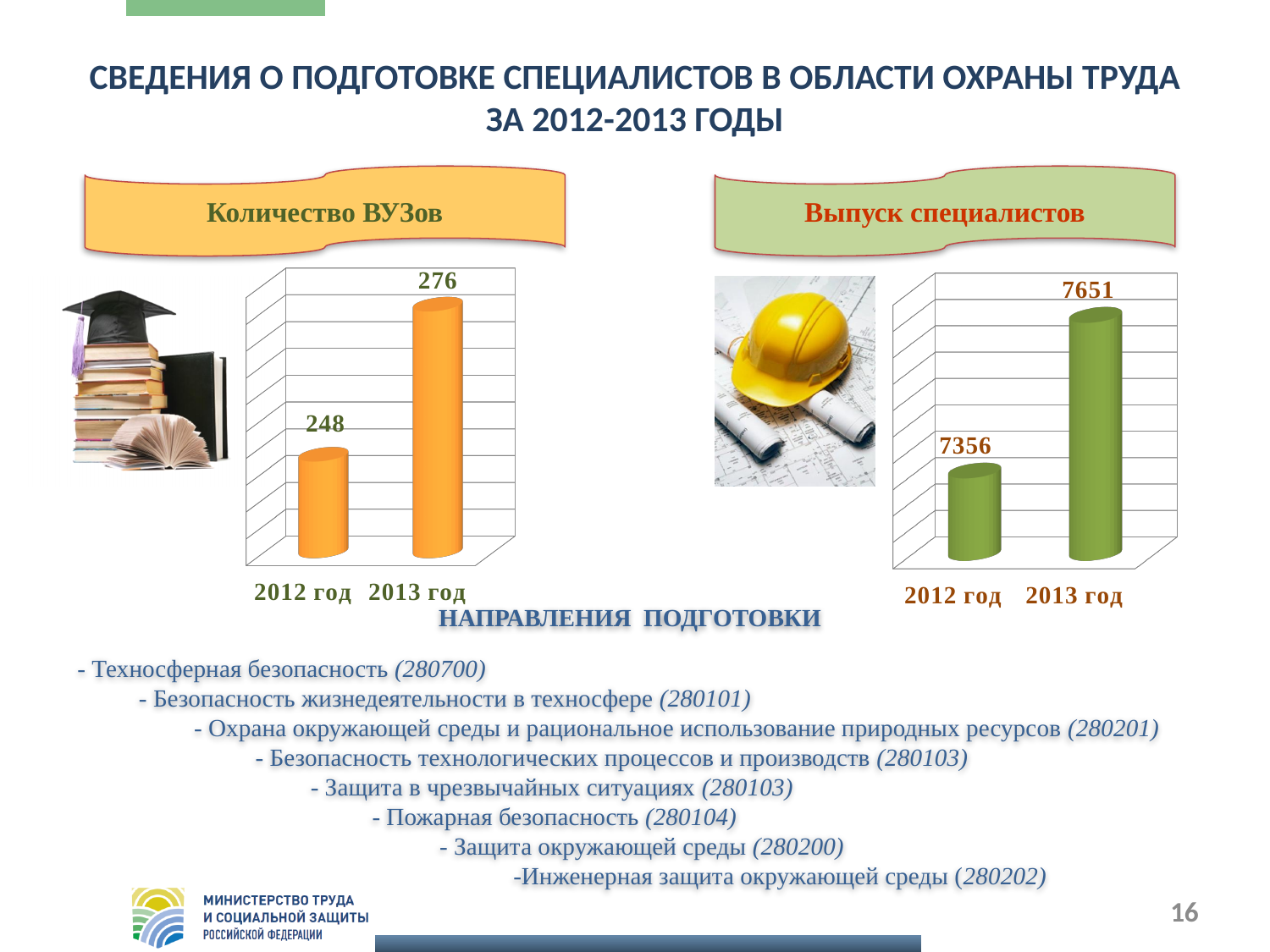
In the "Количество ВУЗов" chart, what is the difference between the 2013 год and 2012 год values? 28 How many categories are shown in the "Количество ВУЗов" chart? 2 In the "Количество ВУЗов" chart, what is the value for 2013 год? 276 In the "Количество ВУЗов" chart, what is the value for 2012 год? 248 In the "Выпуск специалистов" chart, what is the value for 2013 год? 7651 What kind of chart is the "Выпуск специалистов" chart? bar chart In the "Выпуск специалистов" chart, is the value for 2013 год larger or smaller than the value for 2012 год? larger In the "Количество ВУЗов" chart, do the values rise or fall from 2012 год to 2013 год? rise In the "Выпуск специалистов" chart, what is the value for 2012 год? 7356 In the "Выпуск специалистов" chart, which year has the lower value? 2012 год In the "Выпуск специалистов" chart, what is the difference between the 2013 год and 2012 год values? 295 In the "Количество ВУЗов" chart, which year has the higher value? 2013 год